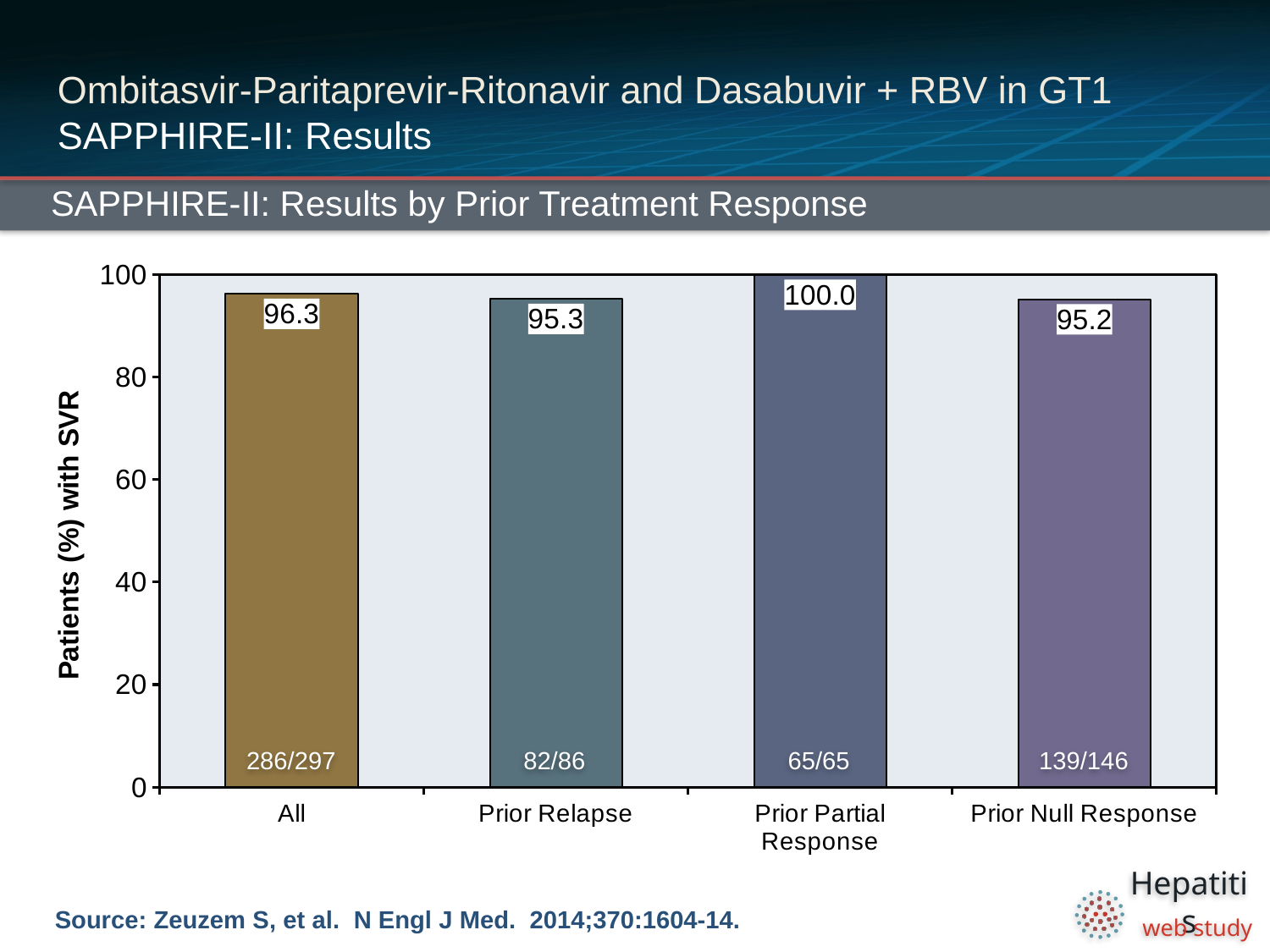
What is the difference in SVR rate between the Prior Partial Response group and the Prior Null Response group? 4.8 What is the SVR rate for the All group? 96.3 What type of chart is shown on the slide? Bar chart Which group has the highest SVR rate? Prior Partial Response Which has a higher SVR rate, the All group or the Prior Null Response group? All What fraction of patients is shown inside the Prior Partial Response bar? 65/65 What fraction of patients is shown inside the All bar? 286/297 How many groups are shown on the x axis? 4 What is the SVR rate for the Prior Relapse group? 95.3 What is the difference in SVR rate between the All group and the Prior Relapse group? 1.0 What is the SVR rate for the Prior Null Response group? 95.2 What is the label of the y axis? Patients (%) with SVR